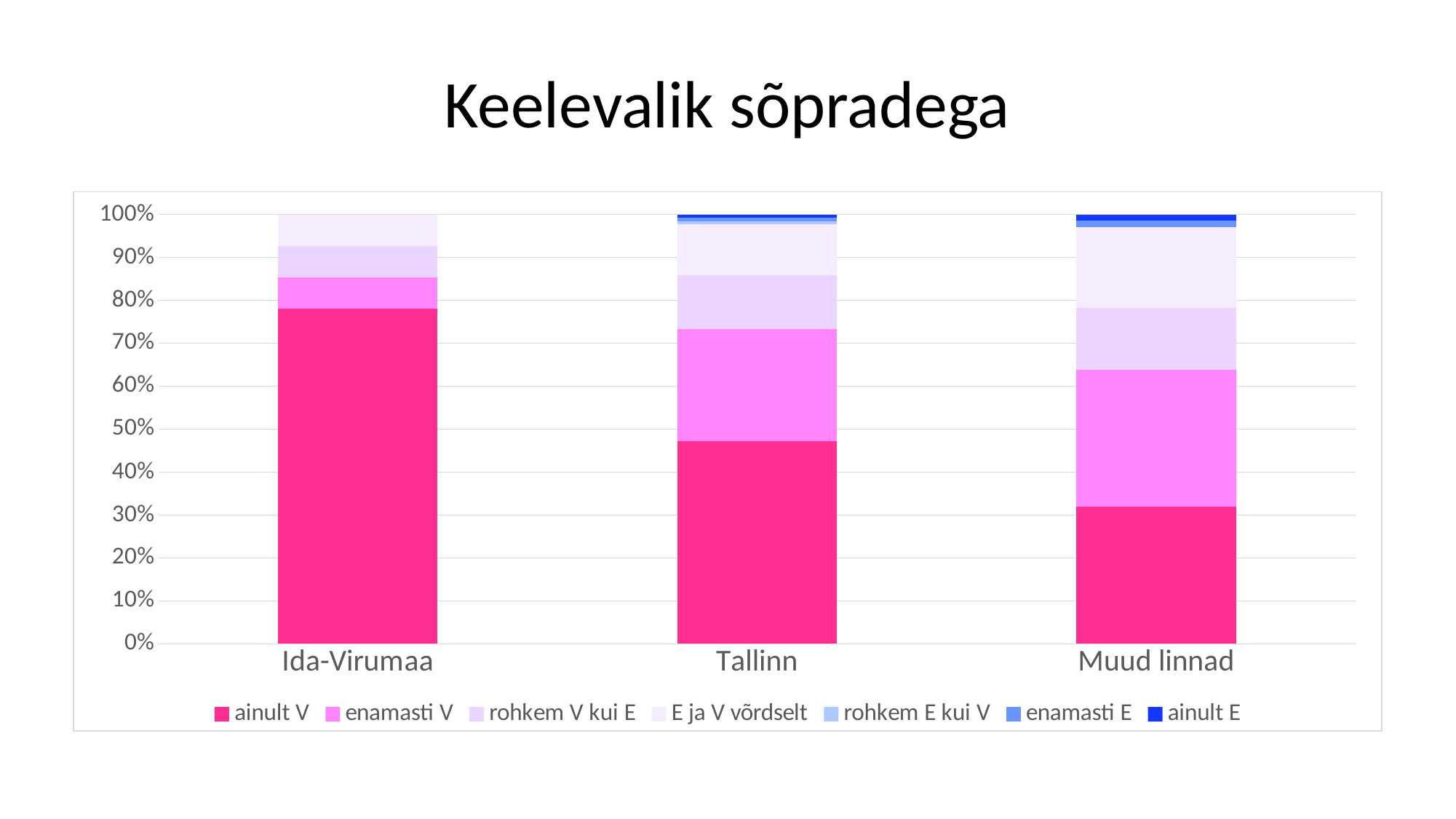
Which category has the largest 'ainult V' segment? Ida-Virumaa Is the 'ainult V' value for Ida-Virumaa greater or less than 70%? greater Is the 'ainult V' value for Muud linnad greater or less than 40%? less How many series does the legend list? 7 How many categories are shown on the x axis? 3 Which is larger, the 'ainult V' segment for Tallinn or for Muud linnad? Tallinn What is the title of the chart? Keelevalik sõpradega Which category has the largest 'enamasti V' segment? Muud linnad What kind of chart is shown on the slide? stacked bar chart Is the 'ainult V' value for Tallinn greater or less than 50%? less Which series is listed last in the legend? ainult E Which category has the smallest 'ainult V' segment? Muud linnad